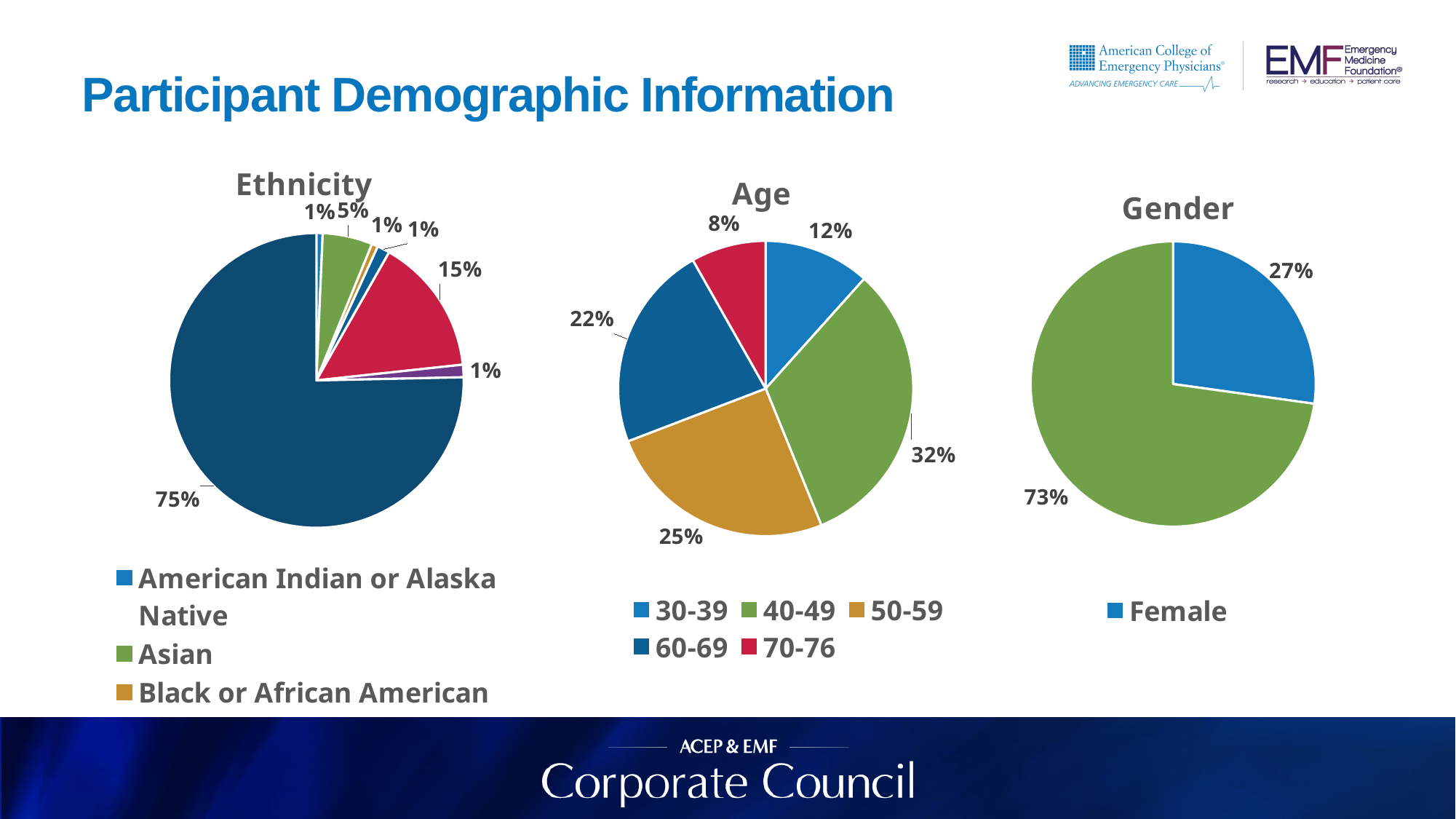
In the Age pie chart, which age group has the largest share? 40-49 In the Age pie chart, what is the difference in percentage points between the 50-59 and 60-69 groups? 3% In the Ethnicity pie chart, what percentage of participants are Asian? 5% How many age groups are shown in the Age pie chart? 5 In the Gender pie chart, what share of participants are Female? 27% In the Age pie chart, what percentage of participants are aged 40-49? 32% In the Age pie chart, which age group has the smallest share? 70-76 What type of chart is used for the Gender chart? Pie chart How many entries does the legend of the Age chart list? 5 In the Ethnicity pie chart, what percentage of participants are Black or African American? 1% In the Ethnicity pie chart, what percentage does the largest slice represent? 75% In the Age pie chart, which group has a larger share: 30-39 or 70-76? 30-39